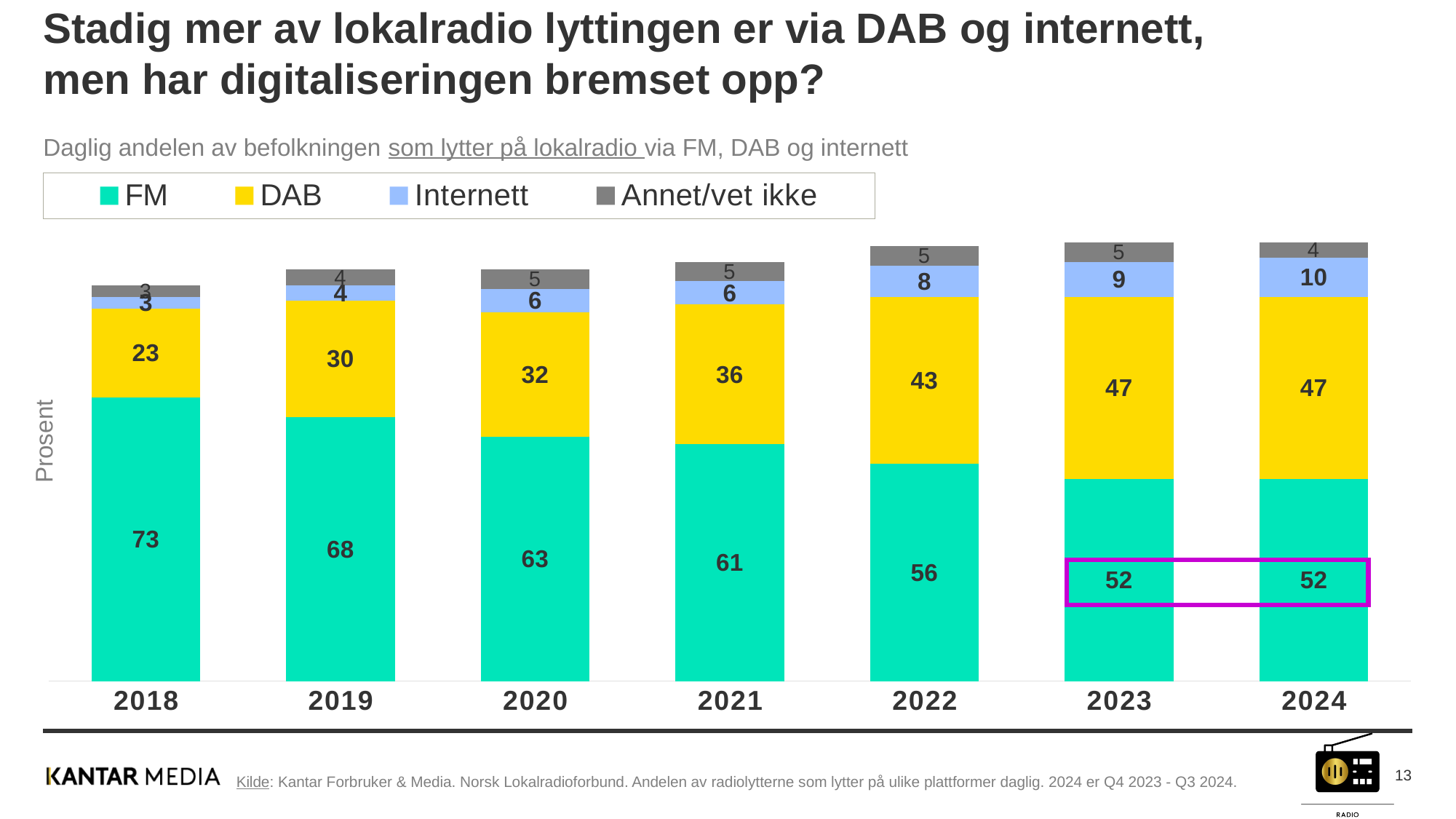
What is the difference between the FM value in 2018 and the FM value in 2024? 21 What is the FM value for 2020? 63 In which year is the DAB value lowest? 2018 What is the total of the stacked bar for 2024? 113 Does the FM value rise or fall from 2018 to 2024? Fall What is the Internett value for 2024? 10 Which is larger in 2023: the FM value or the DAB value? FM How many series does the legend list? 4 In which year is the FM value highest? 2018 What type of chart is shown on the slide? Stacked bar chart How many years are shown on the x axis? 7 What is the DAB value for 2022? 43